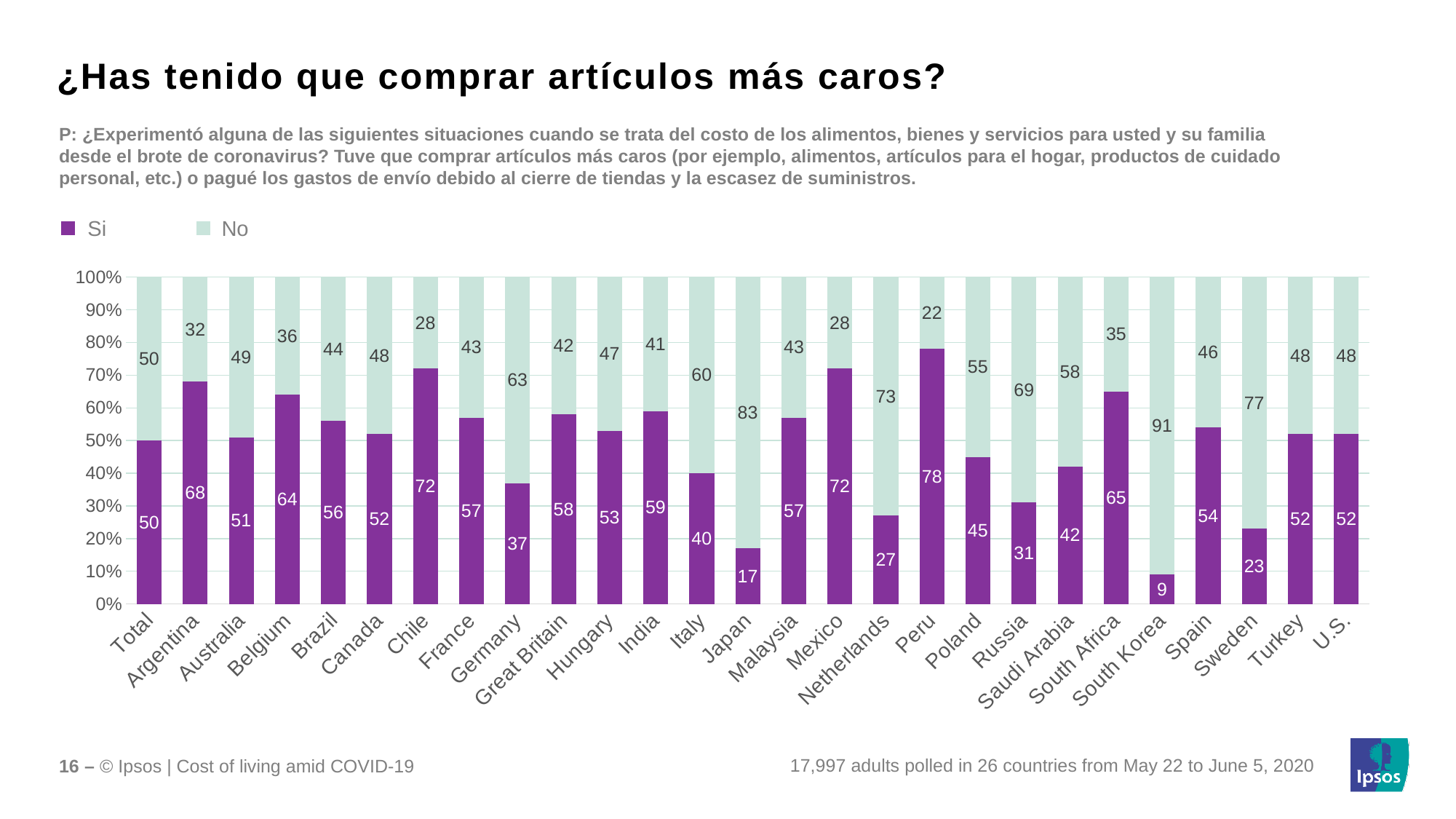
Which country has the highest "Si" value? Peru What kind of chart is shown on the slide? Stacked bar chart Which country has the lowest "Si" value? South Korea How many series does the legend list? 2 What is the total of the stacked bar for Sweden? 100 What is the "No" value for Japan? 83 What is the "Si" value for Peru? 78 What is the difference between the "Si" values for Argentina and Australia? 17 How many countries or categories are shown on the x axis? 27 What is the "Si" value for Germany? 37 Which has a larger "Si" value, Chile or France? Chile What are the two legend entries of the chart? Si and No